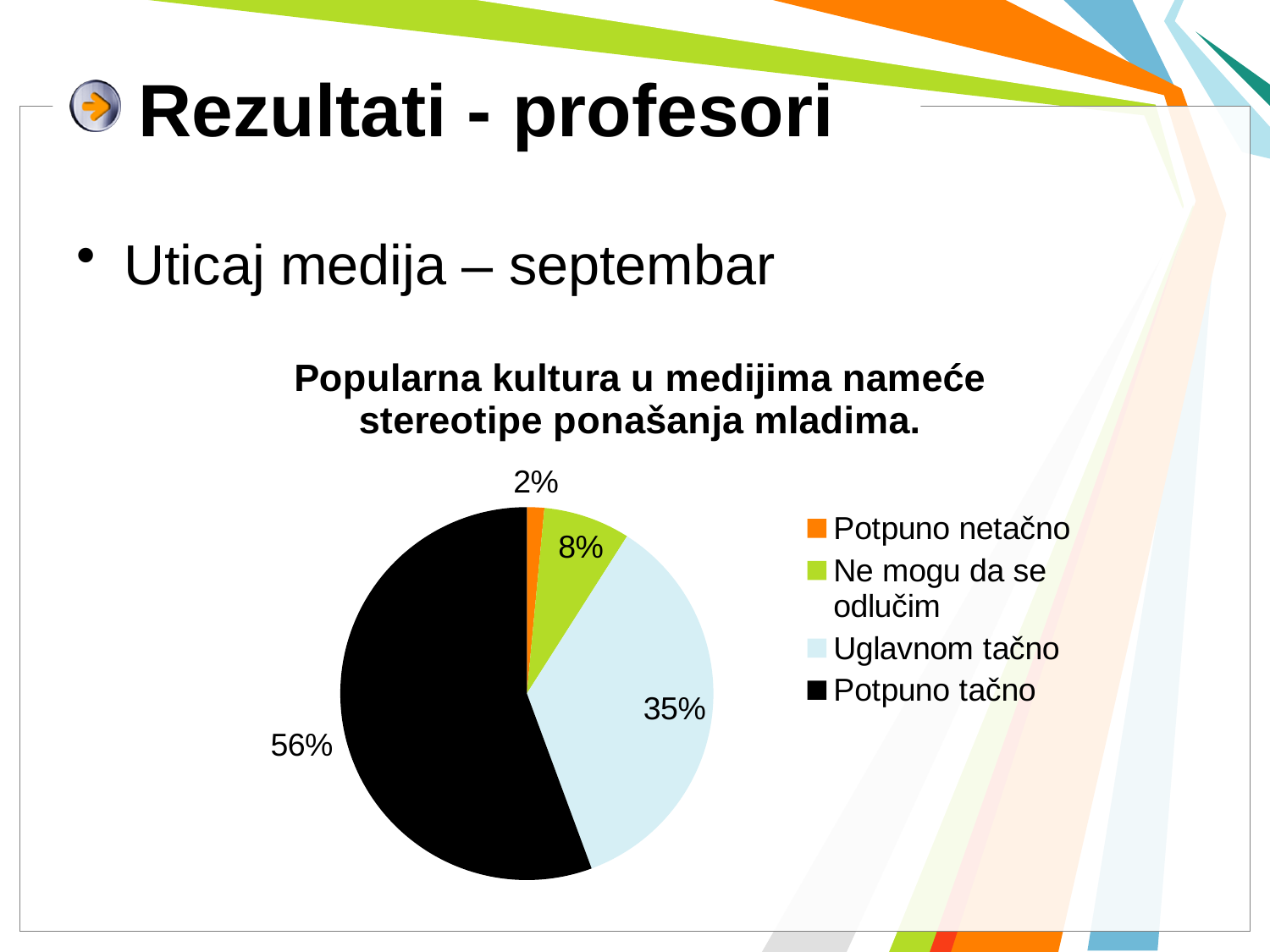
What colour is the slice for "Uglavnom tačno"? light blue Which is larger, the share for "Ne mogu da se odlučim" or the share for "Potpuno netačno"? Ne mogu da se odlučim Which category has the largest slice of the pie? Potpuno tačno What share of the pie is labelled "Potpuno netačno"? 2% What kind of chart is shown on the slide? pie chart What share of the pie is labelled "Uglavnom tačno"? 35% What is the difference between the shares for "Potpuno tačno" and "Uglavnom tačno"? 21% Which category has the smallest slice of the pie? Potpuno netačno What share of the pie is labelled "Ne mogu da se odlučim"? 8% How many categories does the legend list? 4 What is the title of the pie chart? Popularna kultura u medijima nameće stereotipe ponašanja mladima.